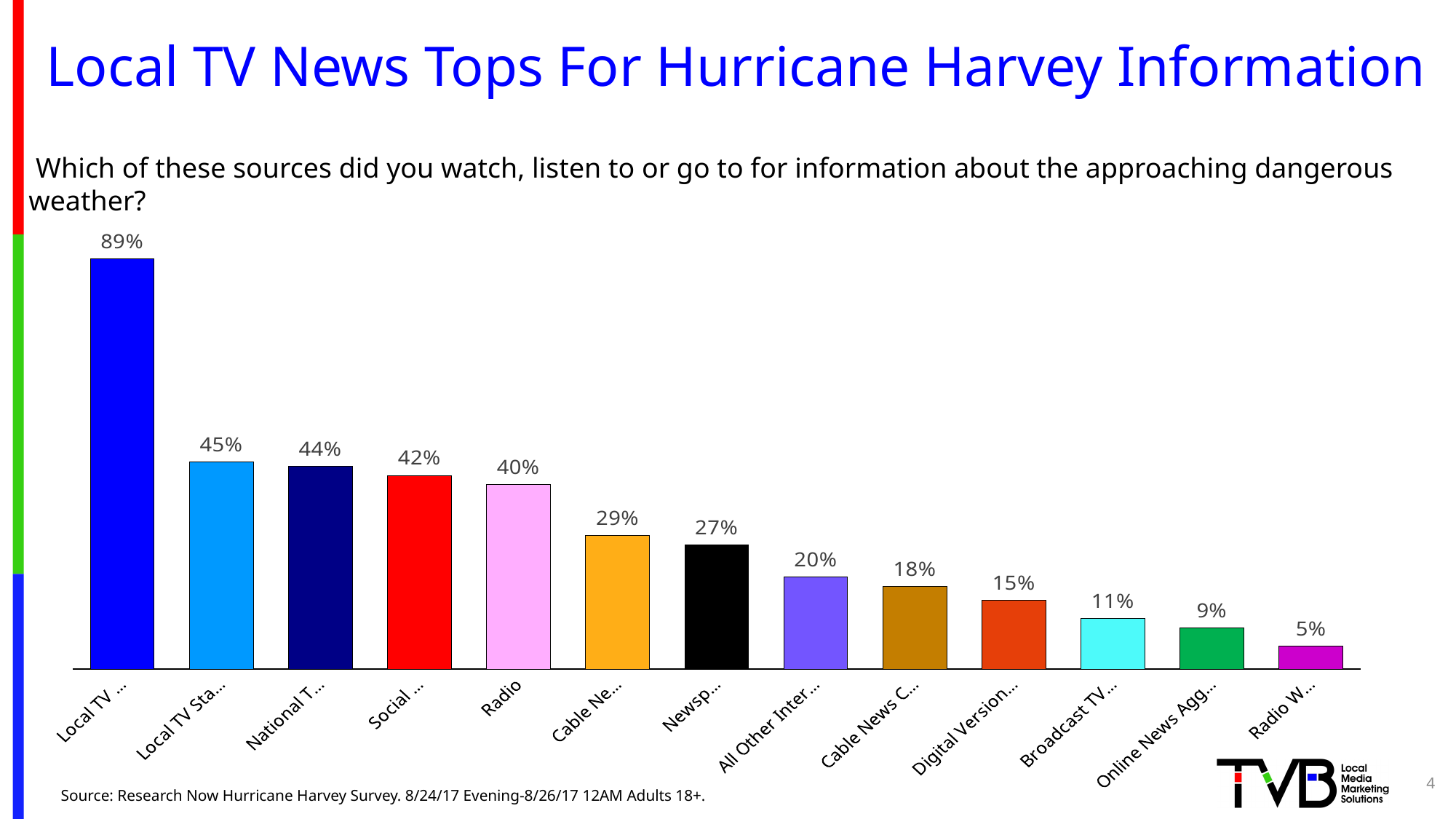
Do the bar values rise or fall moving from left to right across the chart? Fall What is the difference between the second bar (45%) and the third bar (44%)? 1 percentage point What is the lowest value shown in the chart? 5% How many bars (sources) are plotted in the chart? 13 What is the title of the slide? Local TV News Tops For Hurricane Harvey Information What percentage is shown for Radio? 40% What colour is the Radio bar? Pink Which is larger: the value for Radio or the value of the sixth bar (Cable Ne...)? Radio What is the highest value shown in the chart, and which bar has it? 89%, the first bar (Local TV ...) What type of chart is shown on the slide? Bar chart What is the value of the second bar from the left (Local TV Sta...)? 45% What is the difference between the first bar (89%) and Radio (40%)? 49 percentage points